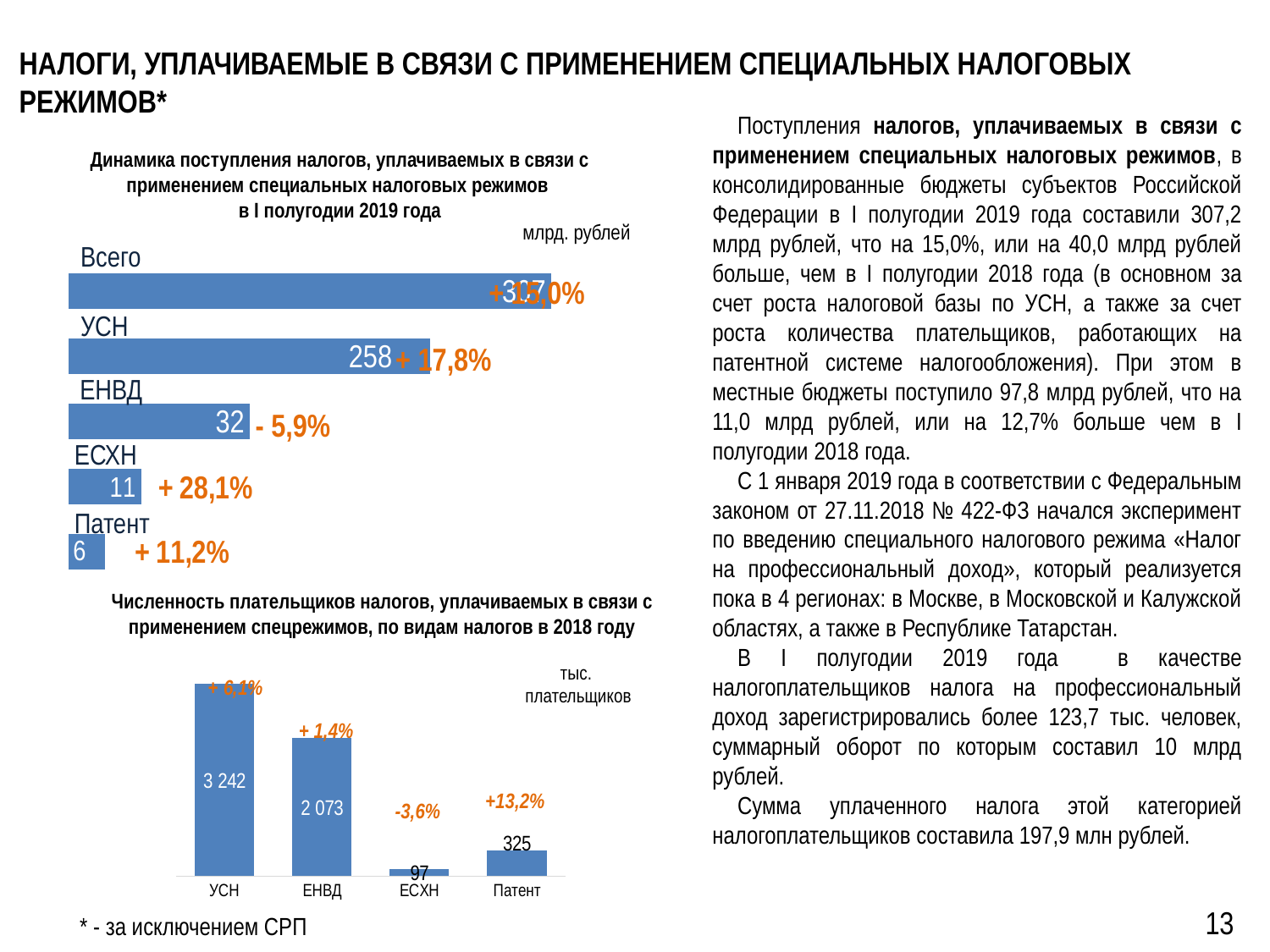
In the bottom chart (Численность плательщиков), how many categories are shown? 4 What type of chart is the bottom chart (Численность плательщиков)? Bar chart In the top chart (Динамика поступления налогов), which category other than Всего has the lowest value? Патент In the bottom chart (Численность плательщиков), which is larger: ЕНВД or Патент? ЕНВД In the top chart (Динамика поступления налогов), what is the difference between the values for УСН and ЕНВД? 226 In the bottom chart (Численность плательщиков), which category has the lowest value? ЕСХН In the top chart (Динамика поступления налогов), which category shows a negative percentage change? ЕНВД In the top chart (Динамика поступления налогов), what is the value for УСН? 258 In the top chart (Динамика поступления налогов), what percentage change is shown for ЕСХН? + 28,1% In the bottom chart (Численность плательщиков), what is the value for УСН? 3 242 In the top chart (Динамика поступления налогов), what is the value for ЕНВД? 32 In the bottom chart (Численность плательщиков), what is the value for Патент? 325